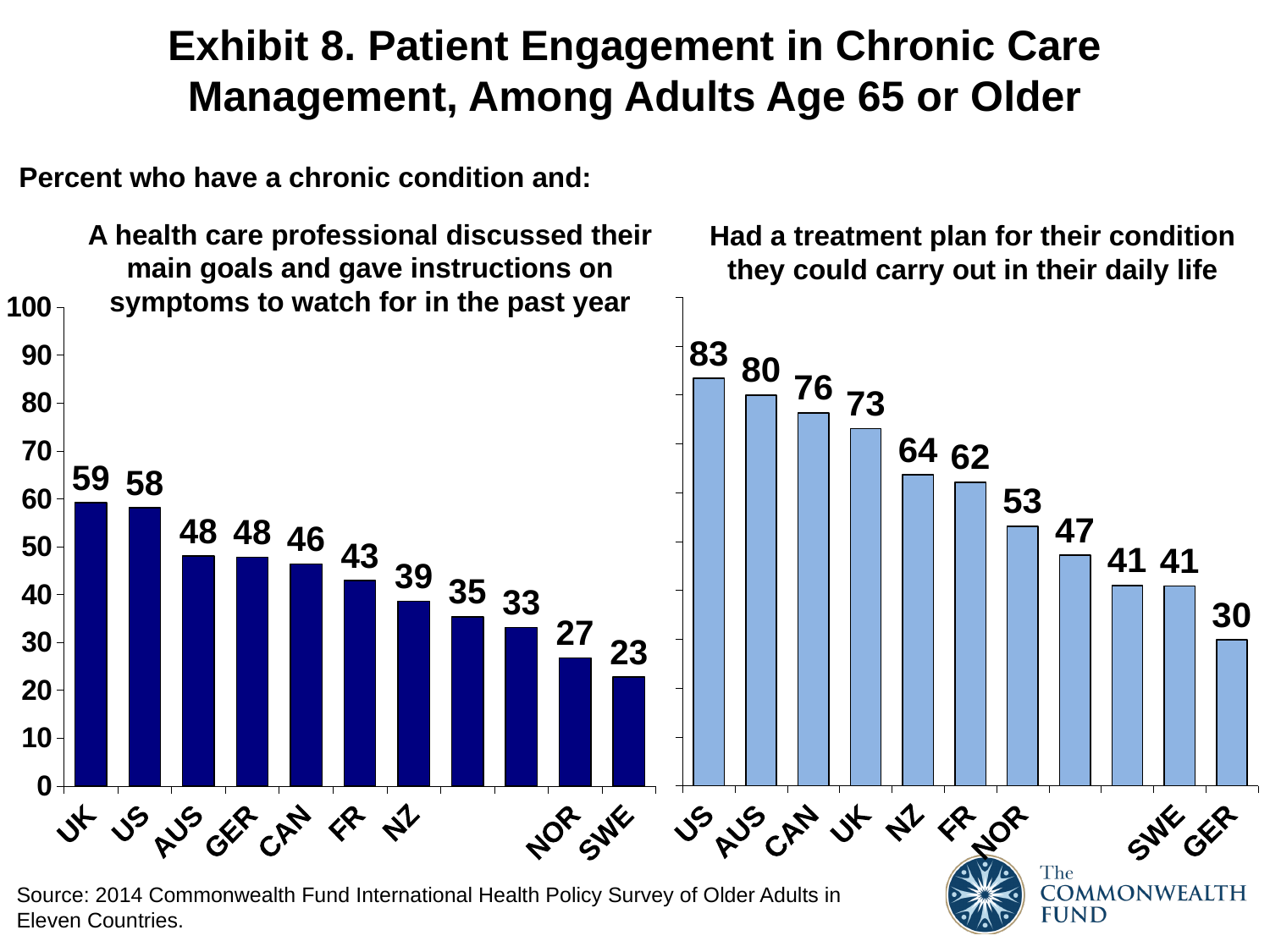
In the right chart (had a treatment plan), what is the value for CAN? 76 In the right chart (had a treatment plan), which country has the lowest value? GER In the right chart (had a treatment plan), is the value for NZ greater or less than 60? greater In the right chart (had a treatment plan), which country has the highest value? US In the left chart (health care professional discussed main goals), what is the value for the UK? 59 In the left chart (health care professional discussed main goals), which country has the highest value? UK In the right chart (had a treatment plan), what is the difference between the values for US and NOR? 30 What kind of chart is the right chart (had a treatment plan)? bar chart In the left chart (health care professional discussed main goals), what is the difference between the values for UK and SWE? 36 In the left chart (health care professional discussed main goals), which is larger, the value for FR or the value for NZ? FR In the right chart (had a treatment plan), do the values rise or fall from left to right? fall How many bars are plotted in the left chart (health care professional discussed main goals)? 11